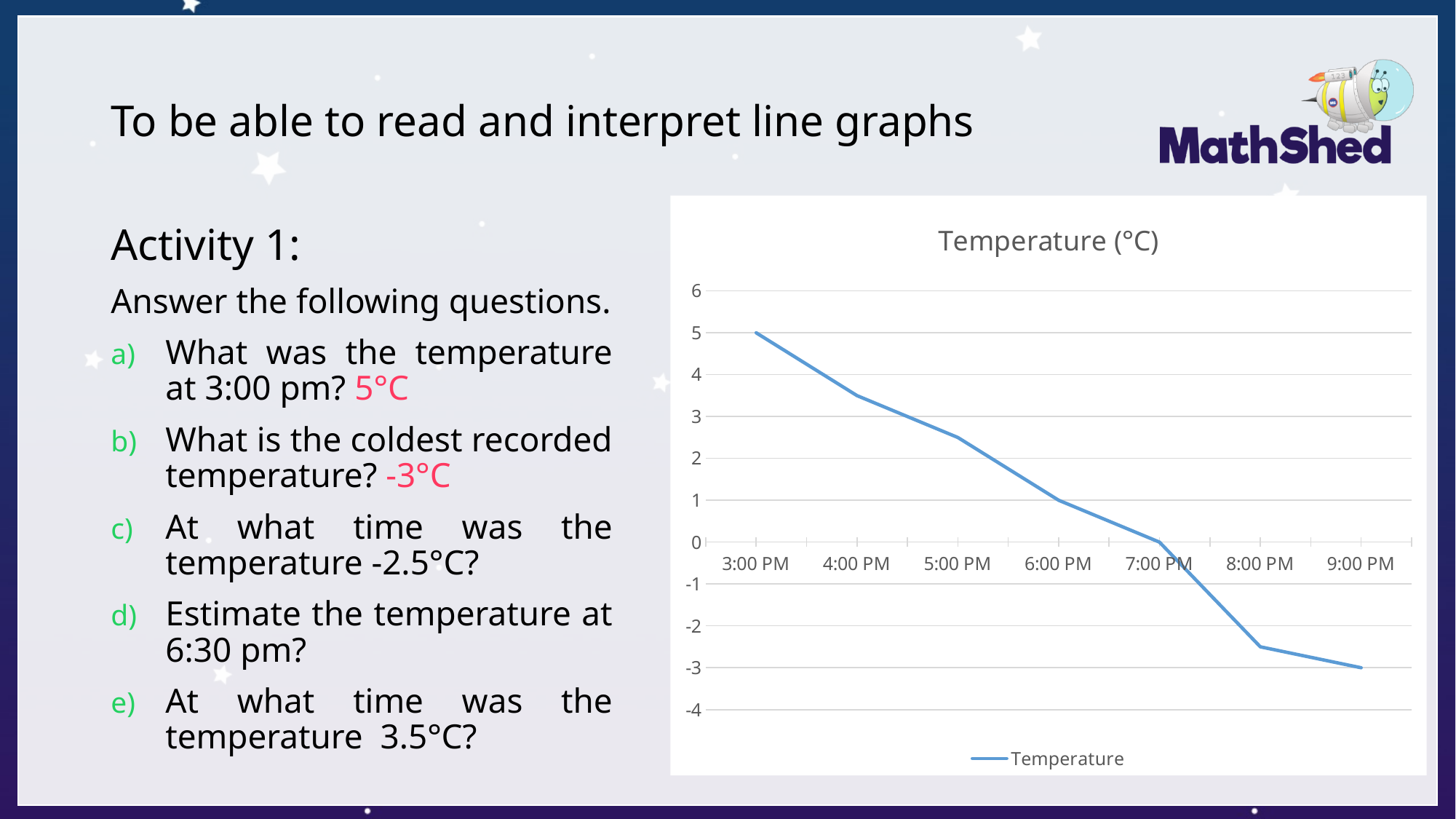
What is the difference between the temperature at 3:00 PM and at 9:00 PM? 8 How many series does the legend list? 1 Does the temperature rise or fall from 3:00 PM to 9:00 PM? fall At which time was the temperature highest? 3:00 PM What was the temperature at 9:00 PM? -3 At which time was the temperature lowest? 9:00 PM How many time points are plotted on the chart? 7 What is the title of the chart? Temperature (°C) What was the temperature at 7:00 PM? 0 Is the temperature at 4:00 PM greater or less than 4? less What was the temperature at 3:00 PM? 5 What kind of chart is shown on the slide? line chart